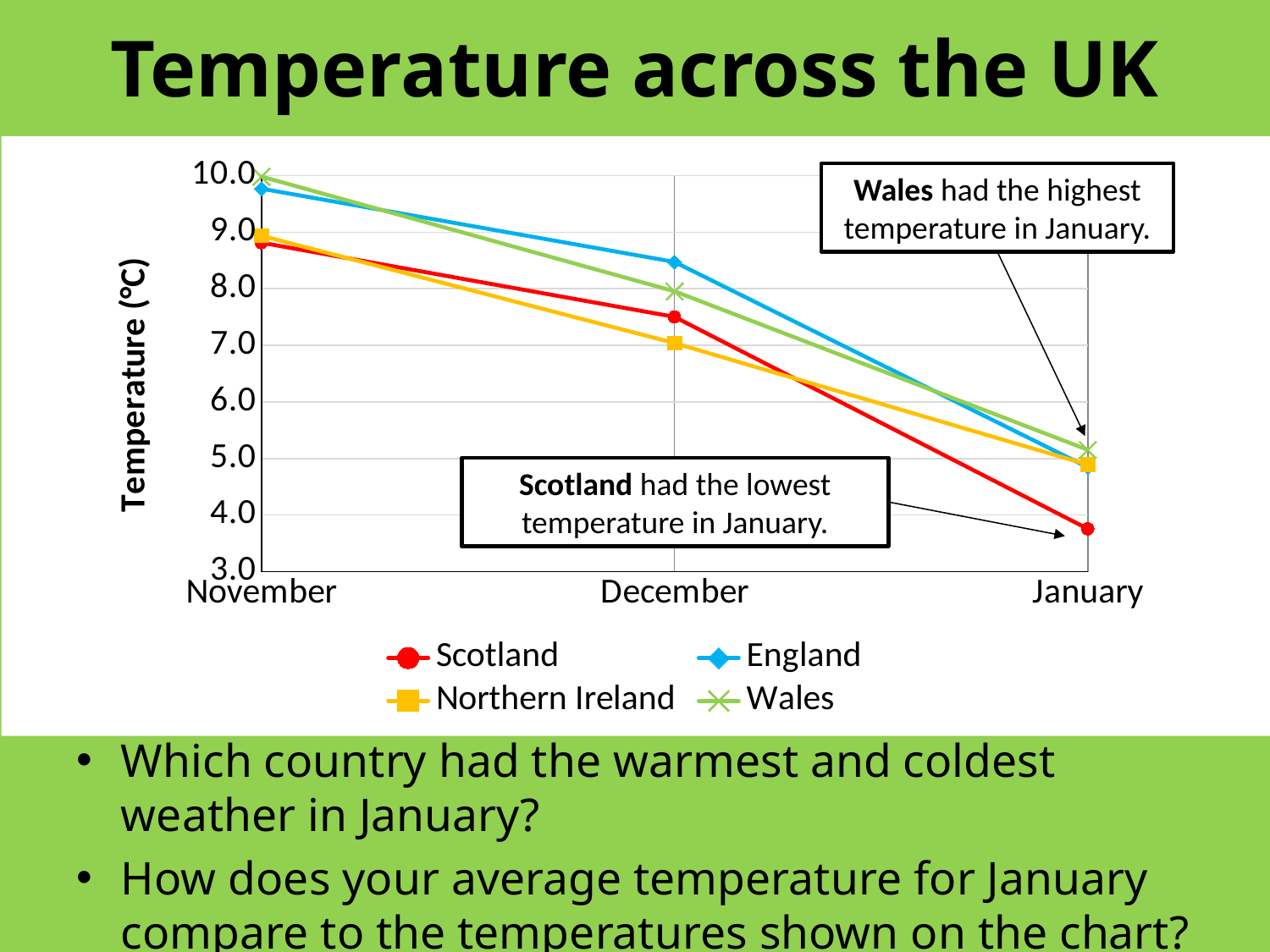
What is the title of the vertical axis? Temperature (°C) How many series does the legend list? 4 How many months are plotted along the x axis? 3 Which country had the highest temperature in January? Wales Which country had the lowest temperature in January? Scotland In December, which had the higher temperature, England or Scotland? England Is the temperature for Scotland in January greater or less than 4.0? less Is the temperature for Scotland in December greater or less than 7.0? greater Is the temperature for England in November greater or less than 9.0? greater Do the temperatures rise or fall from November to January? fall What kind of chart is shown on the slide? line chart